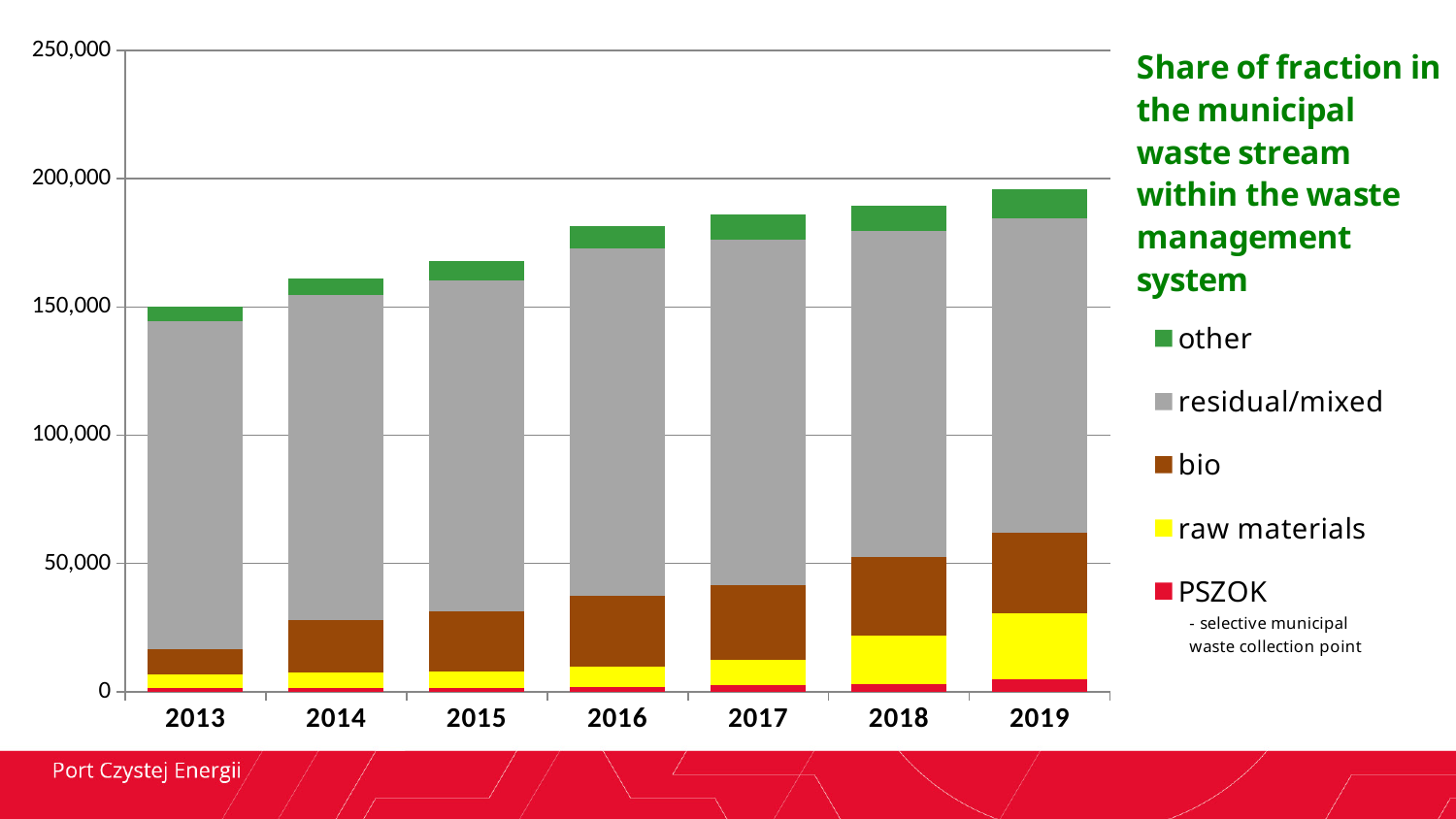
How many years are shown on the x axis of the chart? 7 Do the total bar heights rise or fall from 2013 to 2019? rise Which year has a taller total bar, 2014 or 2018? 2018 What does the legend say PSZOK stands for? selective municipal waste collection point Which series is shown in grey in the chart? residual/mixed Is the total bar for 2019 greater or less than 150,000? greater What kind of chart is shown on the slide? stacked bar chart Which year has the shortest total bar? 2013 Is the total bar for 2019 greater or less than 200,000? less Is the total bar for 2013 greater or less than 200,000? less Which year has the tallest total bar? 2019 How many series does the chart's legend list? 5